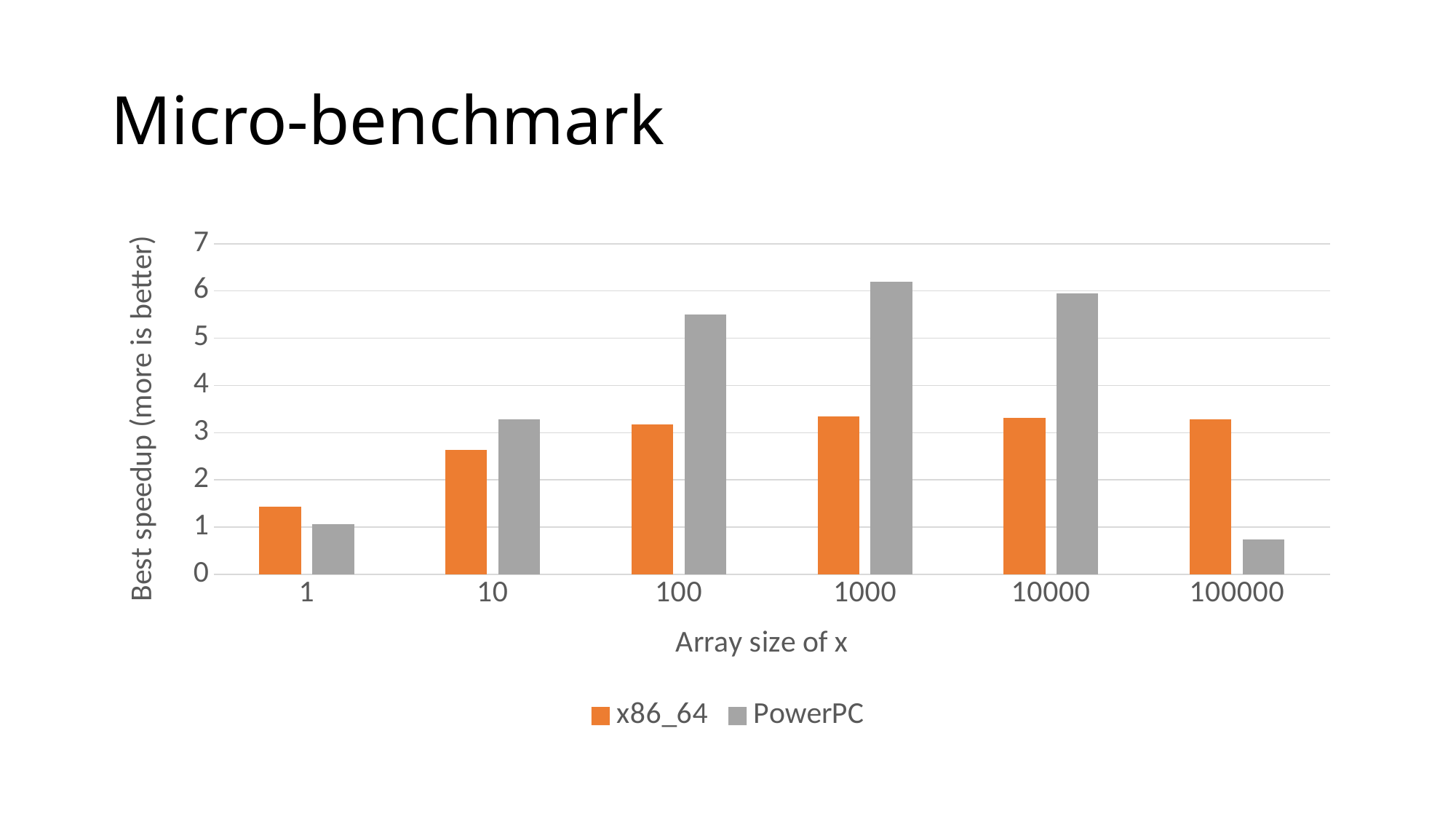
For which array size is the x86_64 speedup lowest? 1 At array size 100, which series has the larger speedup, x86_64 or PowerPC? PowerPC Is the PowerPC value for array size 100000 greater or less than 1? less What kind of chart is shown on the slide? bar chart How many array sizes are shown on the x axis? 6 For which array size is the PowerPC speedup highest? 1000 At array size 100000, which series has the larger speedup, x86_64 or PowerPC? x86_64 For which array size is the PowerPC speedup lowest? 100000 Is the x86_64 value for array size 10 greater or less than 3? less What is the label of the x axis? Array size of x How many series does the legend list? 2 Is the PowerPC value for array size 1000 greater or less than 6? greater